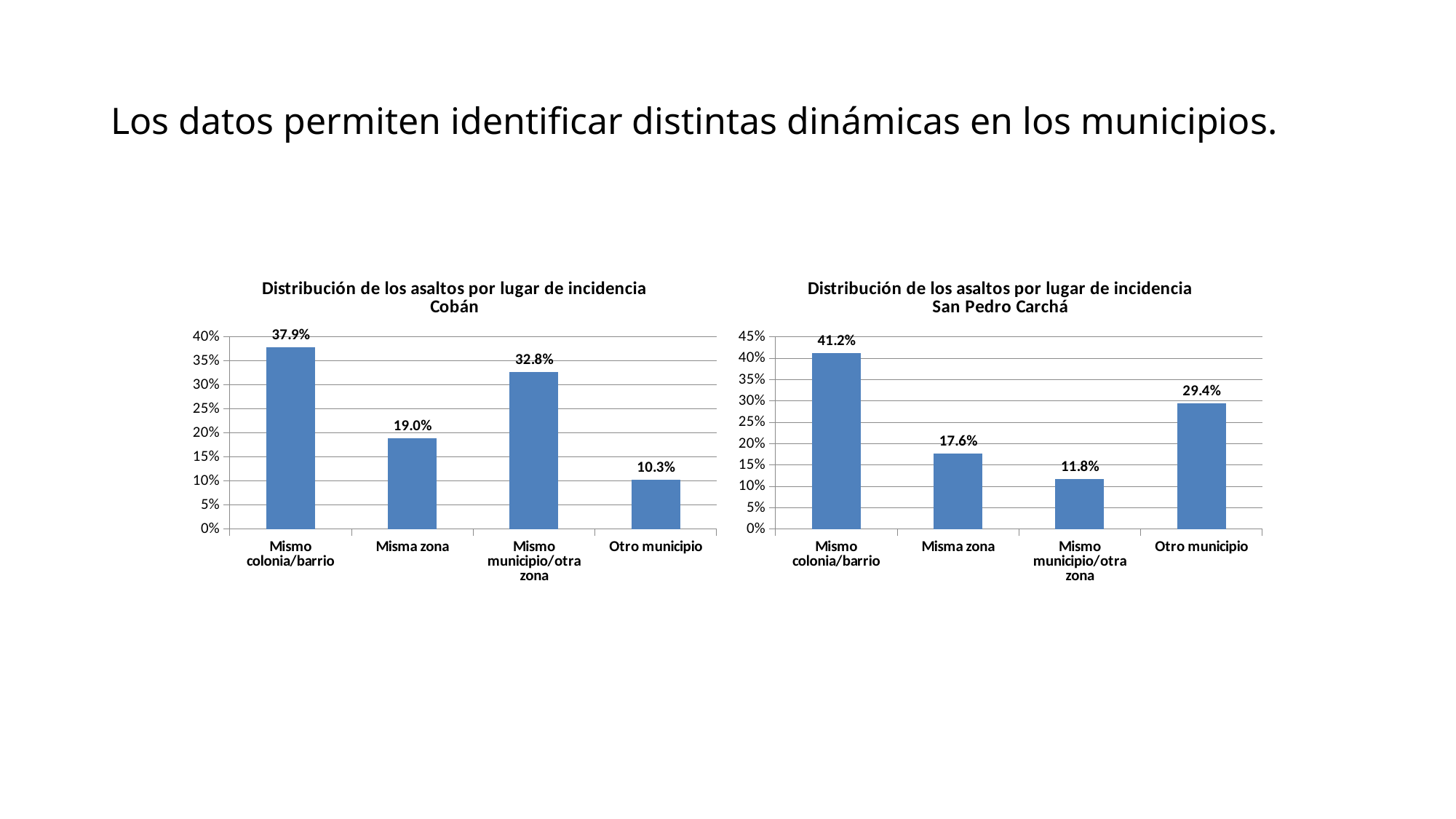
How many categories are shown in the Cobán chart? 4 In the Cobán chart, what is the value for Mismo colonia/barrio? 37.9% What is the title of the chart on the left? Distribución de los asaltos por lugar de incidencia Cobán In the Cobán chart, what is the difference between Mismo colonia/barrio and Mismo municipio/otra zona? 5.1% In the San Pedro Carchá chart, which is larger: Misma zona or Mismo municipio/otra zona? Misma zona What type of chart is the San Pedro Carchá chart? Bar chart In the San Pedro Carchá chart, what is the difference between Mismo colonia/barrio and Otro municipio? 11.8% In the Cobán chart, which category has the highest value? Mismo colonia/barrio In the Cobán chart, which category has the lowest value? Otro municipio In the San Pedro Carchá chart, what is the value for Otro municipio? 29.4% In the San Pedro Carchá chart, which category has the lowest value? Mismo municipio/otra zona In the Cobán chart, what is the value for Misma zona? 19.0%